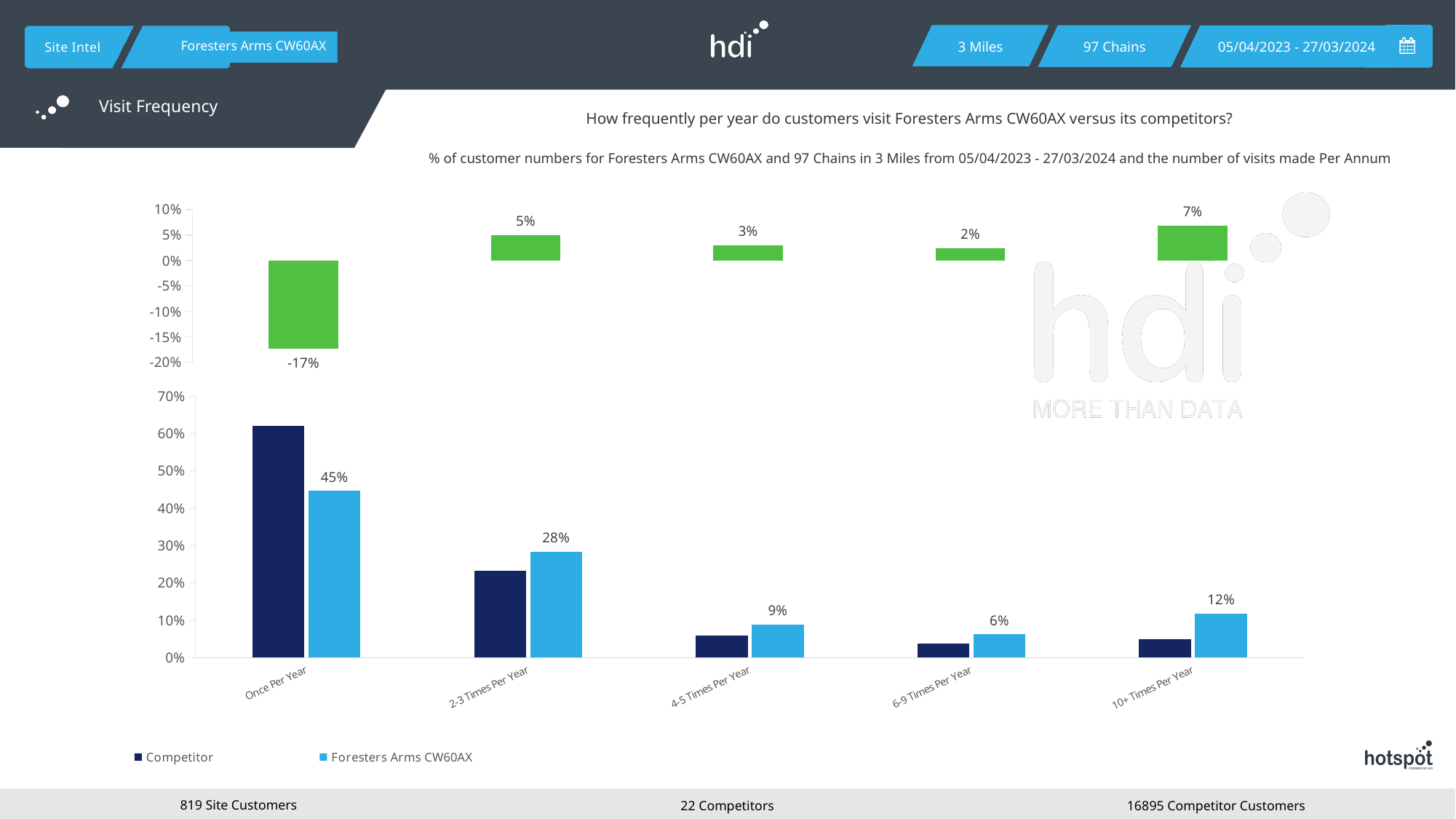
What kind of chart is the bottom chart? bar chart How many categories are shown on the x axis of the bottom chart? 5 In the bottom chart, for Once Per Year, which series has the larger value: Competitor or Foresters Arms CW60AX? Competitor In the bottom chart, is the Competitor value for Once Per Year greater or less than 50%? greater How many series does the legend of the bottom chart list? 2 In the bottom chart, what is the value for Foresters Arms CW60AX for Once Per Year? 45% In the bottom chart, is the Competitor value for 6-9 Times Per Year greater or less than 10%? less In the bottom chart, what is the difference between the Foresters Arms CW60AX values for 2-3 Times Per Year and 4-5 Times Per Year? 19 percentage points In the bottom chart, what is the value for Foresters Arms CW60AX for 10+ Times Per Year? 12% In the top chart, what is the value for Once Per Year? -17%